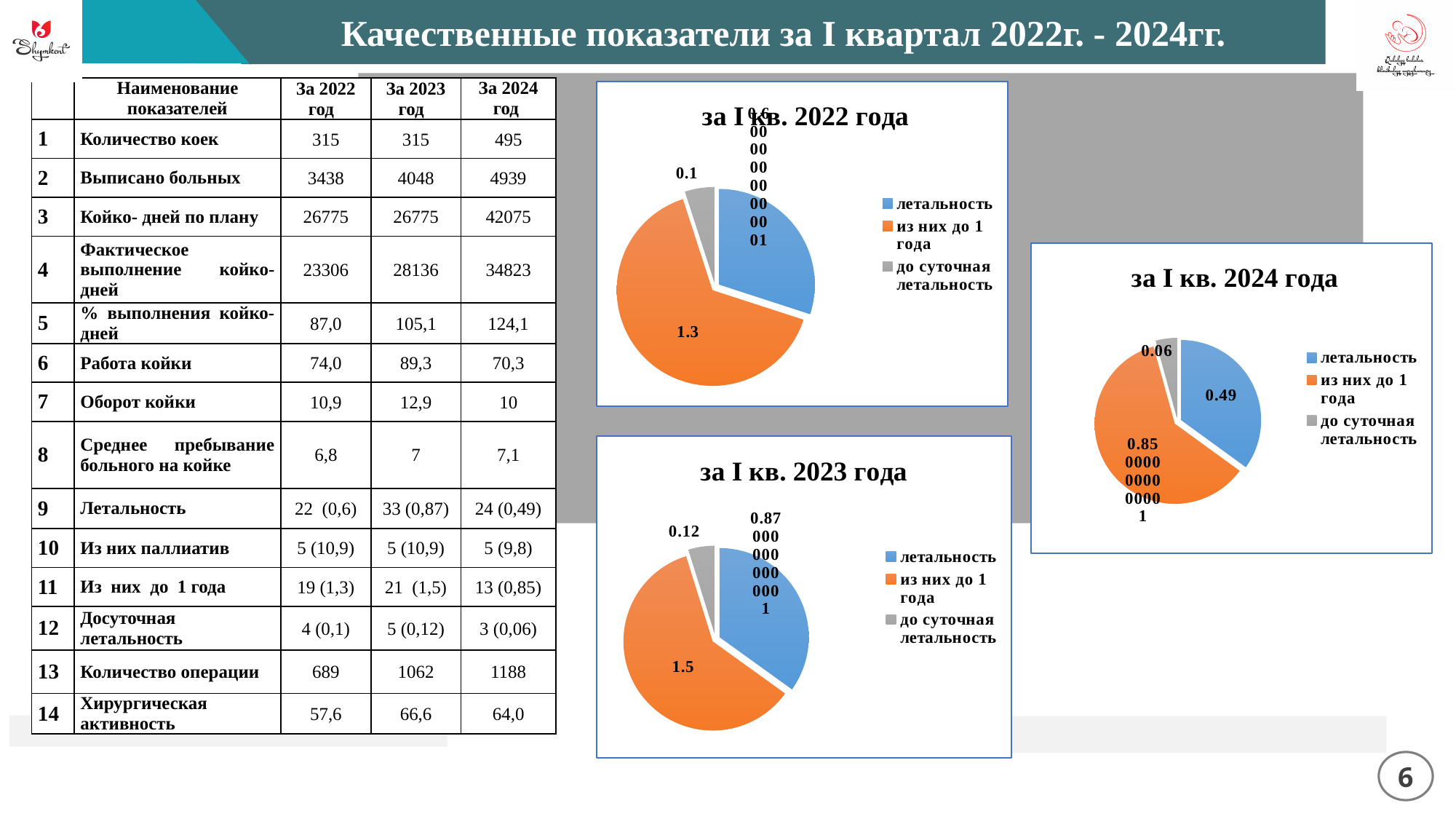
In the chart "за I кв. 2022 года", what is the value for "до суточная летальность"? 0.1 In the chart "за I кв. 2023 года", which category has the smallest slice? до суточная летальность What kind of chart is "за I кв. 2022 года"? pie chart In the chart "за I кв. 2023 года", what is the difference between "из них до 1 года" and "до суточная летальность"? 1.38 In the chart "за I кв. 2023 года", what is the value for "из них до 1 года"? 1.5 In the chart "за I кв. 2022 года", which category has the largest slice? из них до 1 года In the chart "за I кв. 2024 года", which is larger: "летальность" or "до суточная летальность"? летальность How many entries does the legend of the chart "за I кв. 2024 года" list? 3 In the chart "за I кв. 2022 года", what is the value for "из них до 1 года"? 1.3 In the chart "за I кв. 2024 года", what is the value for "до суточная летальность"? 0.06 In the chart "за I кв. 2023 года", what is the value for "до суточная летальность"? 0.12 In the chart "за I кв. 2024 года", what is the value for "летальность"? 0.49